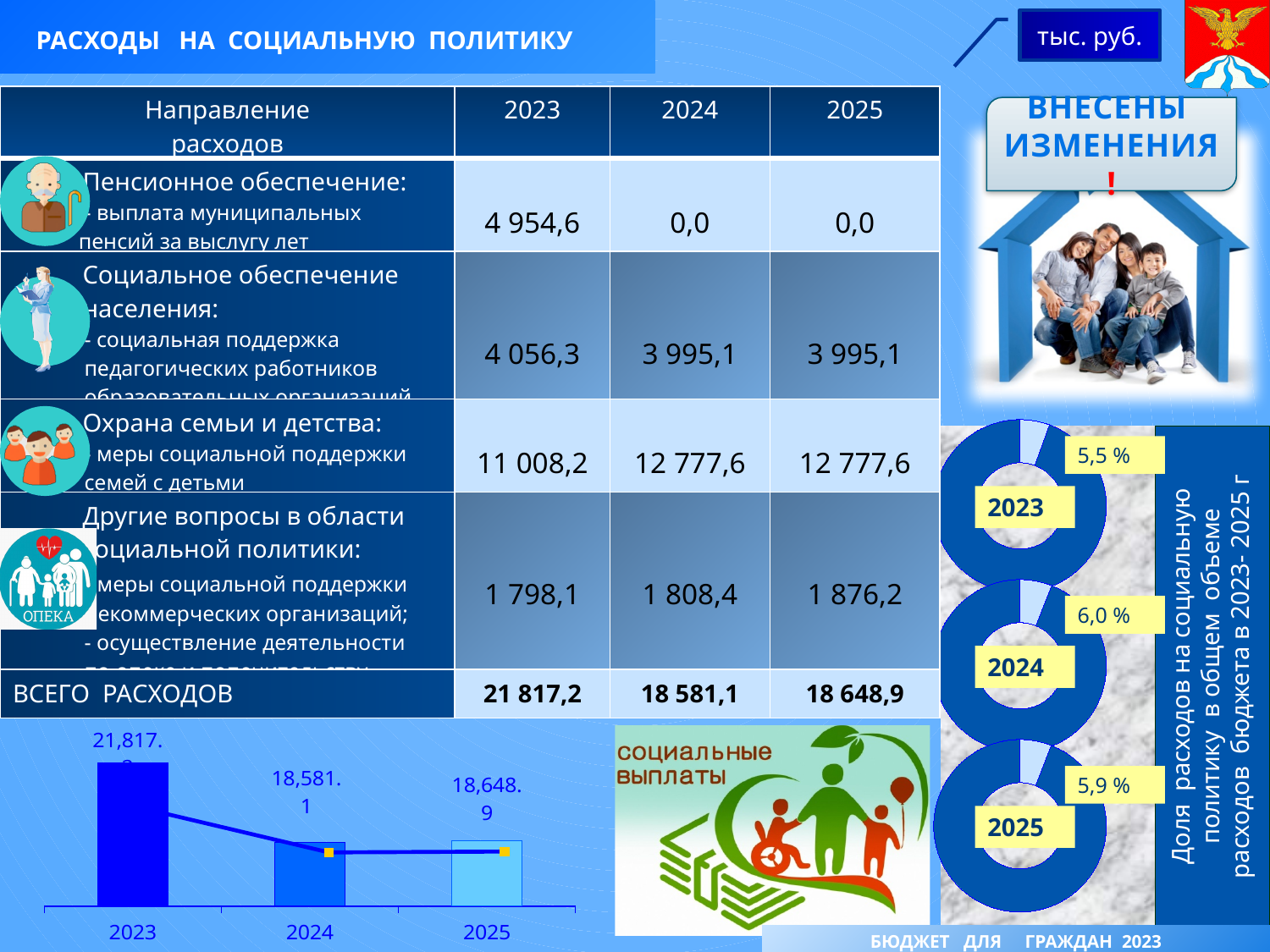
In the bar chart at the bottom left, what is the value for 2025? 18,648.9 In the bar chart at the bottom left, which is larger: the value for 2024 or for 2025? 2025 In the bar chart at the bottom left, which year has the highest value? 2023 In the bar chart at the bottom left, what is the value for 2024? 18,581.1 In the bar chart at the bottom left, how do the values change from 2023 to 2025? fall sharply, then rise slightly In the bar chart at the bottom left, which year has the lowest value? 2024 In the ring charts on the right of the slide, what share is shown for 2023? 5,5 % How many years are plotted in the bar chart at the bottom left? 3 In the bar chart at the bottom left, what is the difference between the values for 2025 and 2024? 67.8 In the ring charts on the right of the slide, what share is shown for 2024? 6,0 % In the ring charts on the right of the slide, which year has the highest share? 2024 What kind of chart is shown at the bottom left of the slide? bar chart